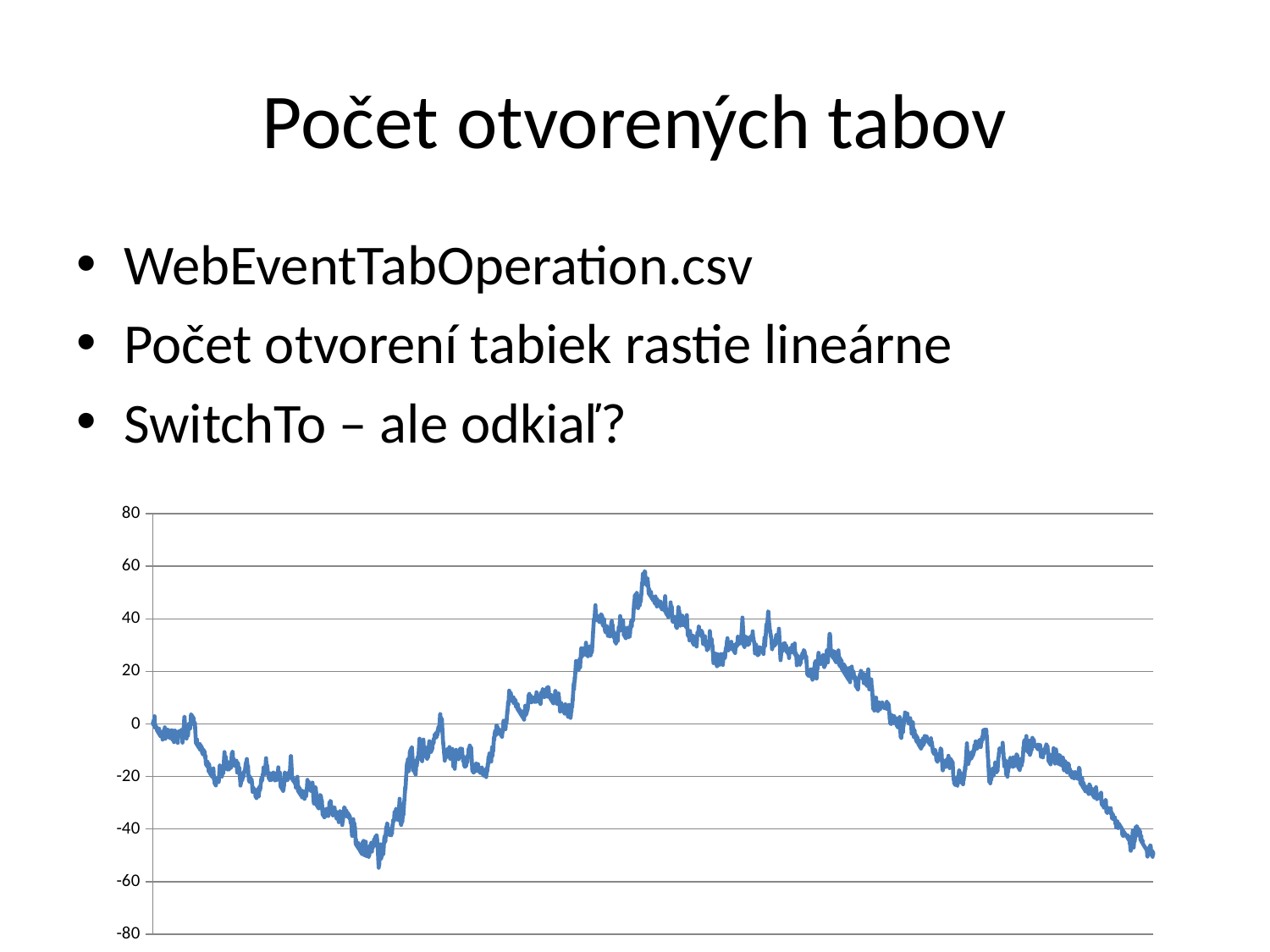
Does the line ever drop below -60? no What kind of chart is shown on the slide? line chart What is the lowest value shown on the vertical axis? -80 Is the highest point reached by the line greater or less than 40? greater Over the right-hand portion of the chart, does the line rise or fall? fall Does the line end higher or lower than where it starts? lower Is the value at the left end of the line greater or less than 20? less What is the highest value shown on the vertical axis? 80